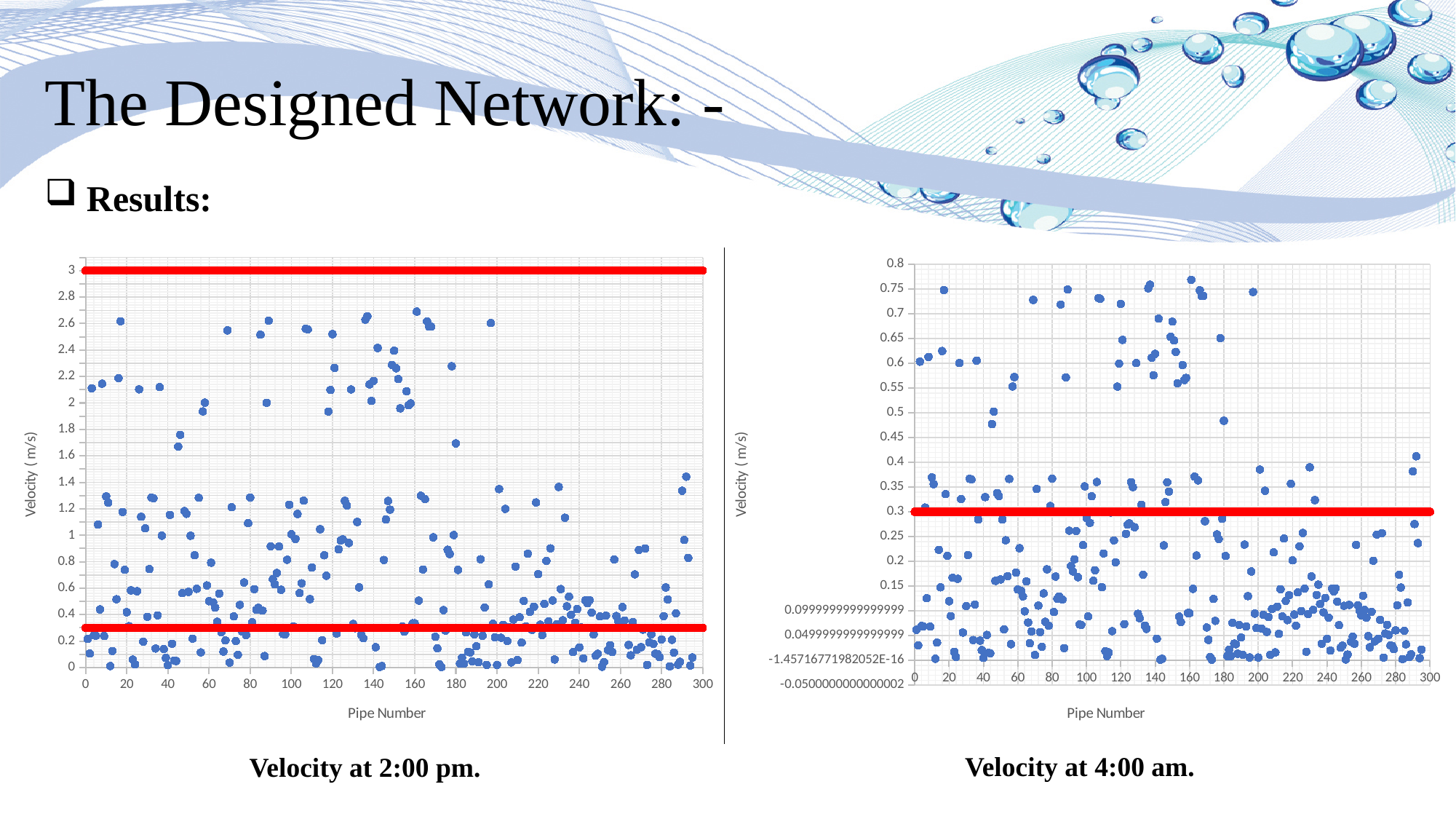
In the 'Velocity at 4:00 am.' chart, what is the largest value shown on the x axis? 300 In the 'Velocity at 4:00 am.' chart, at what velocity value is the red horizontal line drawn? 0.3 In the 'Velocity at 4:00 am.' chart, is the highest plotted velocity greater or less than 0.8? less In the 'Velocity at 2:00 pm.' chart, at what velocity value is the upper red horizontal line drawn? 3 What kind of chart is the 'Velocity at 2:00 pm.' chart on the left? scatter chart In the 'Velocity at 4:00 am.' chart, what is the label of the y axis? Velocity ( m/s) In the 'Velocity at 2:00 pm.' chart, what is the label of the x axis? Pipe Number In the 'Velocity at 2:00 pm.' chart, is the highest plotted velocity greater or less than 2.8? less What kind of chart is the 'Velocity at 4:00 am.' chart on the right? scatter chart Which chart has the larger maximum value on its y axis, 'Velocity at 2:00 pm.' or 'Velocity at 4:00 am.'? Velocity at 2:00 pm. In the 'Velocity at 2:00 pm.' chart, is the highest plotted velocity greater or less than 2.6? greater